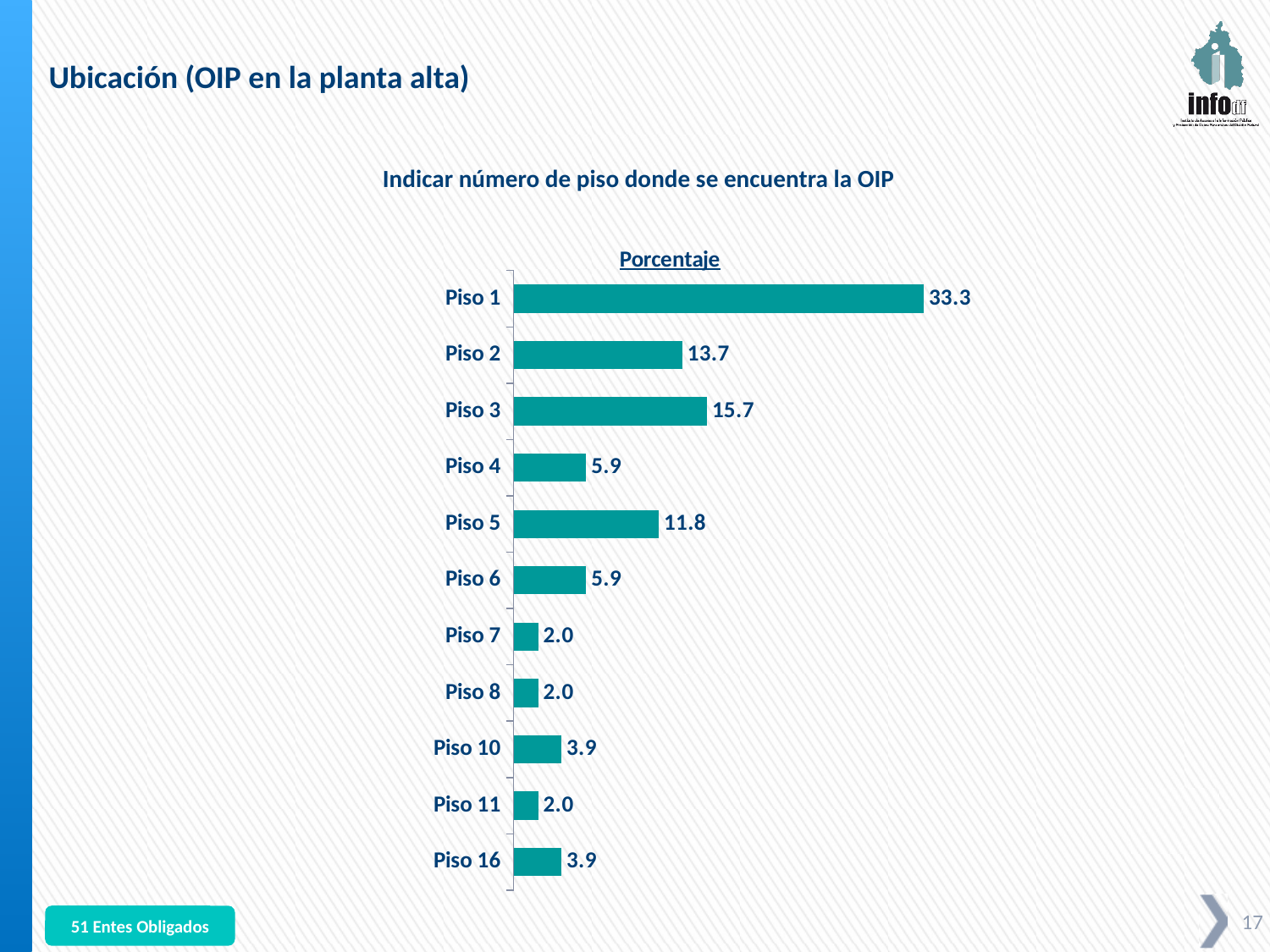
What is the title of the chart? Porcentaje Which is larger, the value for Piso 3 or the value for Piso 2? Piso 3 What kind of chart is shown on the slide? Bar chart What is the value for Piso 5? 11.8 What is the difference between the values for Piso 3 and Piso 2? 2.0 Which category has the highest value? Piso 1 What is the value for Piso 1? 33.3 How many categories have a value of 2.0? 3 Which is larger, the value for Piso 4 or the value for Piso 5? Piso 5 What is the difference between the values for Piso 1 and Piso 5? 21.5 What is the value for Piso 10? 3.9 How many categories are shown in the chart? 11